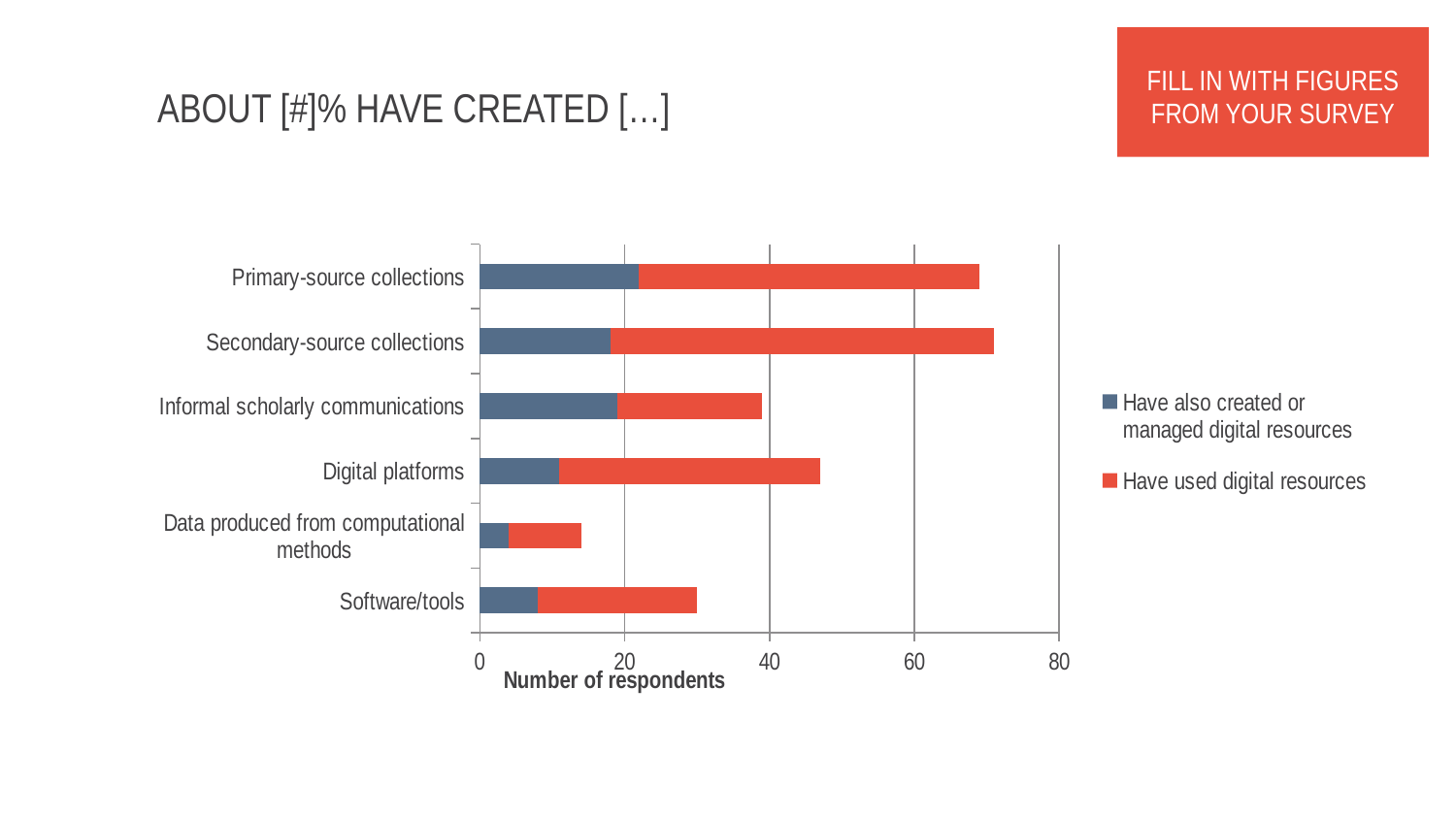
How many categories are shown on the chart? 6 Which has a longer total bar, Digital platforms or Software/tools? Digital platforms Which category has the shortest total bar? Data produced from computational methods Is the total number of respondents for Digital platforms greater or less than 40? greater Is the total number of respondents for Software/tools greater or less than 40? less What is the label of the horizontal axis? Number of respondents Is the total number of respondents for Primary-source collections greater or less than 60? greater Which has a longer total bar, Primary-source collections or Informal scholarly communications? Primary-source collections What kind of chart is shown on the slide? Stacked bar chart Which series is shown in red in the legend? Have used digital resources How many series does the legend list? 2